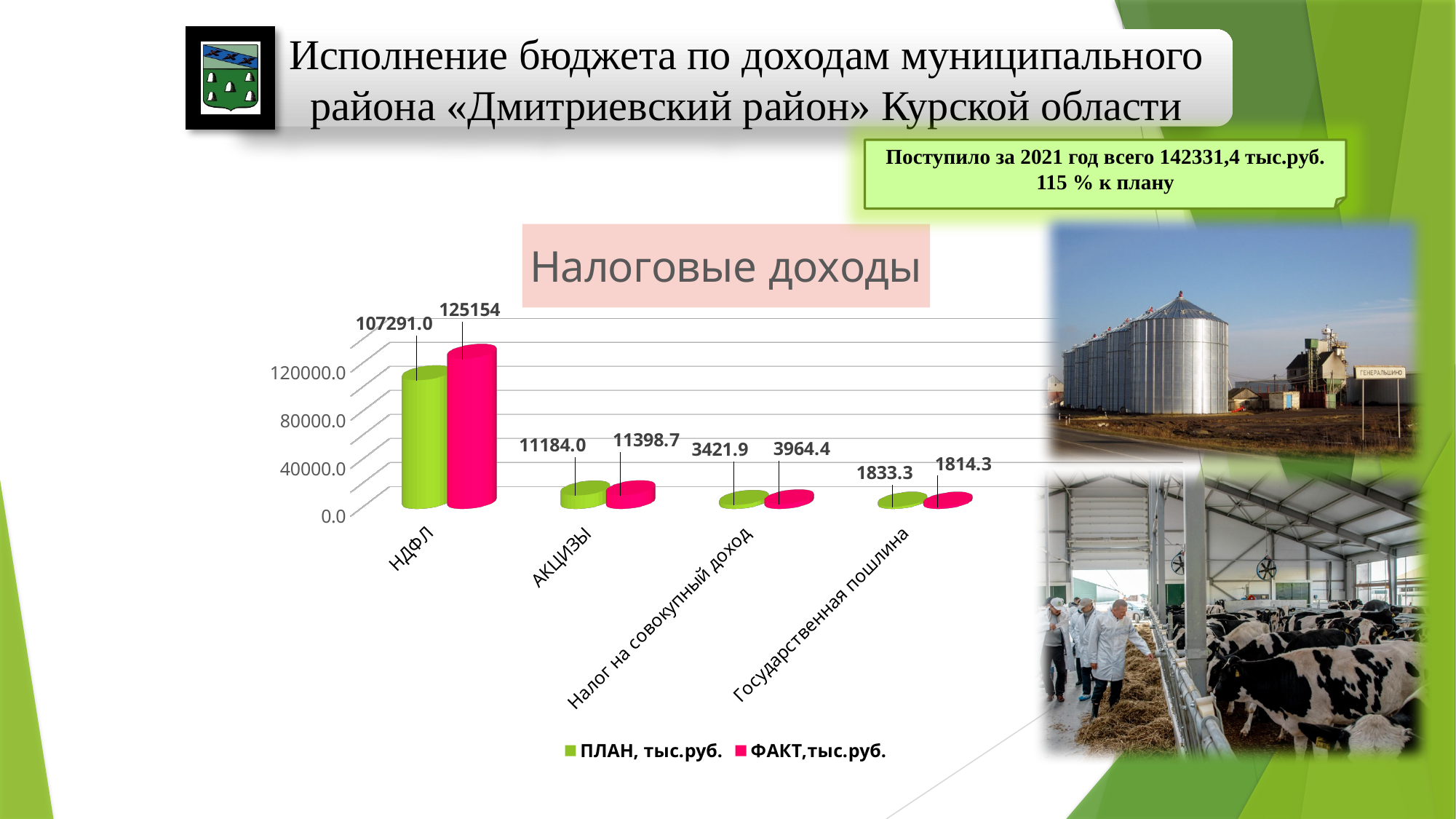
Which category has the highest ФАКТ value? НДФЛ What type of chart is shown under the title "Налоговые доходы"? bar chart What is the ПЛАН value for Налог на совокупный доход? 3421.9 What is the ФАКТ value for АКЦИЗЫ? 11398.7 How many series does the chart legend list? 2 What is the ПЛАН value for НДФЛ? 107291.0 What is the ФАКТ value for Государственная пошлина? 1814.3 For АКЦИЗЫ, which is larger: the ПЛАН value or the ФАКТ value? ФАКТ Which category has the lowest ПЛАН value? Государственная пошлина How many categories are shown on the x axis of the chart? 4 What is the difference between the ФАКТ and ПЛАН values for НДФЛ? 17863.0 What is the ФАКТ value for НДФЛ? 125154